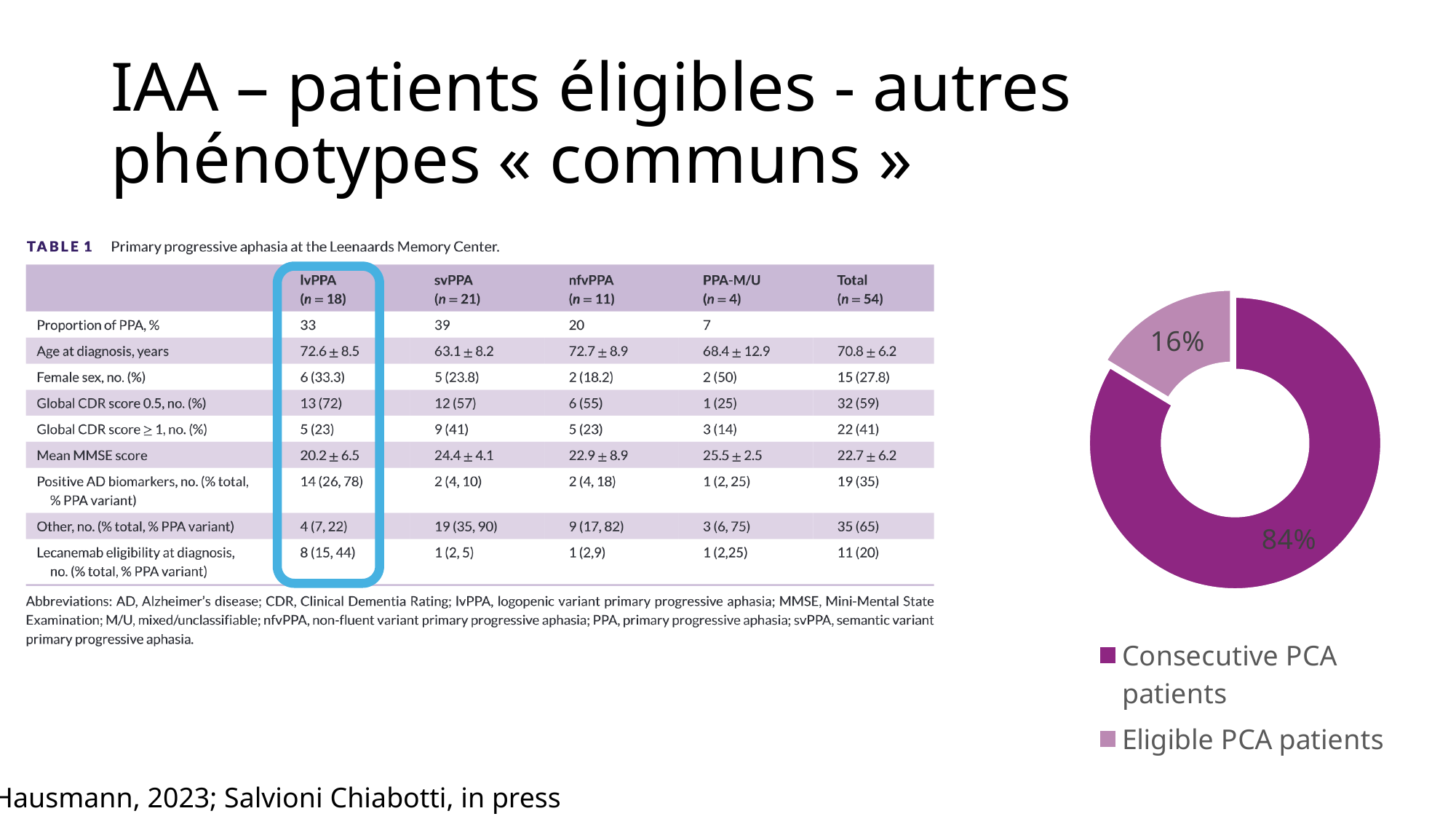
In the doughnut chart, what share is labelled for Eligible PCA patients? 16% In the doughnut chart, is the share for Eligible PCA patients greater or less than 20%? less Which legend entry of the doughnut chart is shown in the lighter purple colour? Eligible PCA patients Which slice of the doughnut chart is the largest? Consecutive PCA patients How many entries does the legend of the doughnut chart list? 2 What is the difference in percentage points between the two slices of the doughnut chart? 68 Which slice of the doughnut chart is the smallest? Eligible PCA patients How many slices does the doughnut chart have? 2 In the doughnut chart, which is larger: Consecutive PCA patients or Eligible PCA patients? Consecutive PCA patients What kind of chart is shown on the right of the slide? Doughnut chart In the doughnut chart, what share is labelled for Consecutive PCA patients? 84% What is the total of the two percentages shown on the doughnut chart? 100%